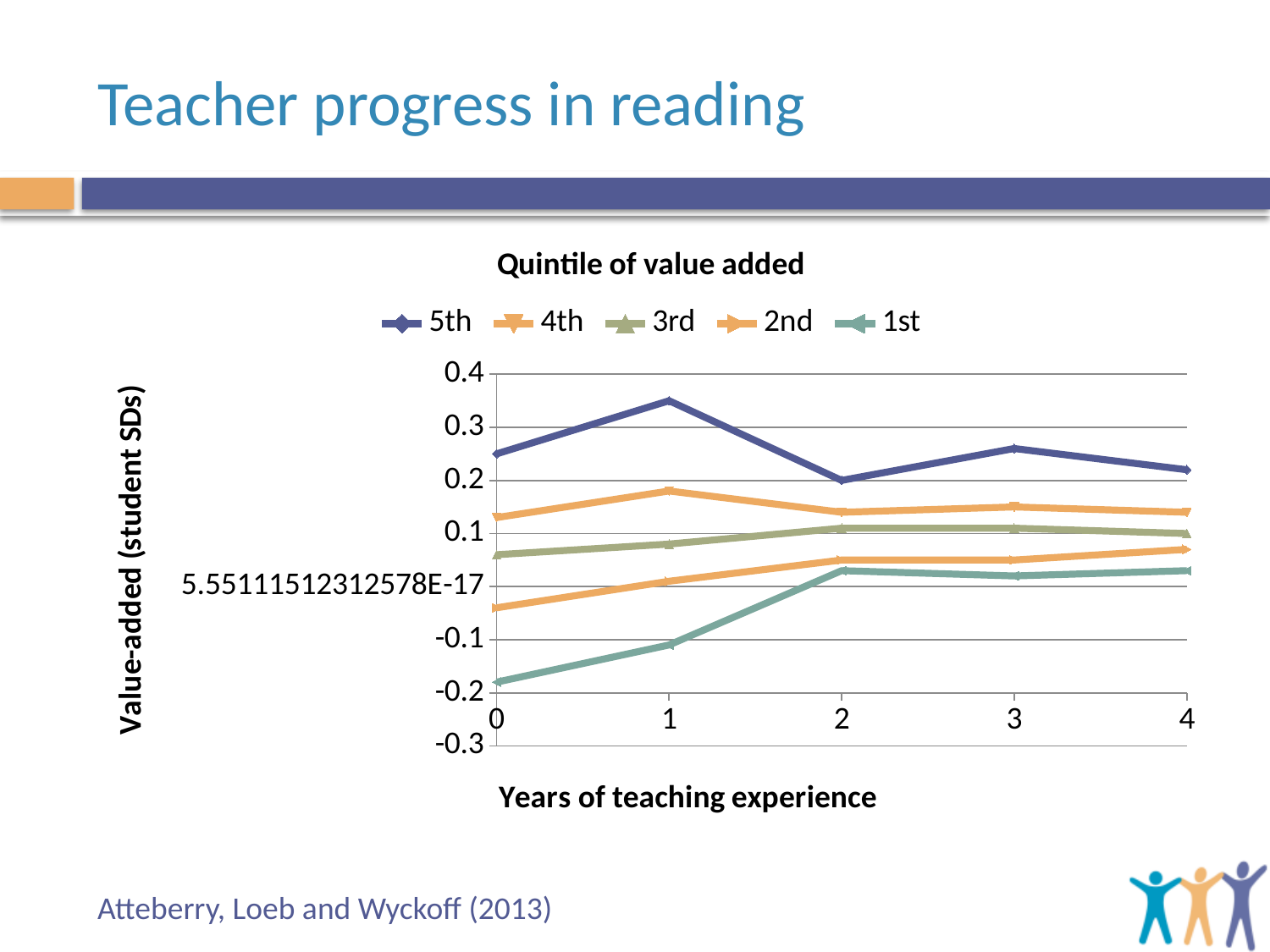
Which quintile series has the lowest value at 0 years of teaching experience? 1st At 2 years of teaching experience, which is larger: the 5th quintile or the 4th quintile? 5th Is the value for the 2nd quintile at 0 years of experience greater or less than 0? less What kind of chart is shown on the slide? line chart Which quintile series has the highest value at 1 year of teaching experience? 5th What is the title of the x axis? Years of teaching experience Is the value for the 1st quintile at 0 years of experience greater or less than -0.1? less At which year of teaching experience does the 5th quintile series reach its highest value? 1 How many years of teaching experience are plotted along the x axis? 5 How many series does the legend list? 5 Does the 1st quintile series rise or fall between 0 and 2 years of teaching experience? rise Is the value for the 5th quintile at 1 year of experience greater or less than 0.3? greater